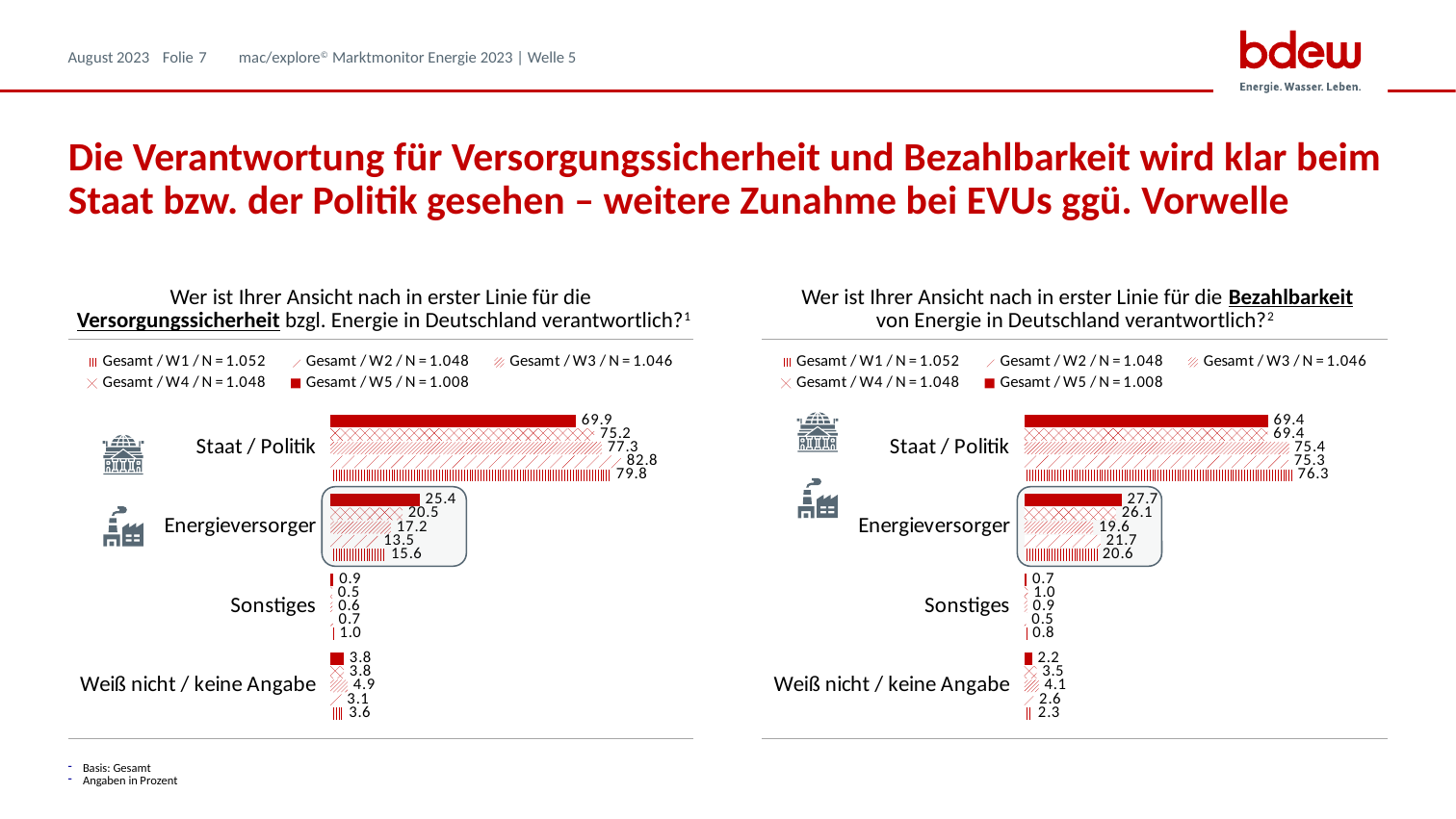
How many categories are shown in the right chart (Bezahlbarkeit)? 4 In the right chart (Bezahlbarkeit), what is the value of the solid red bar (Gesamt / W5) for Energieversorger? 27.7 What sample size (N) is given for Gesamt / W5 in the legend of the right chart (Bezahlbarkeit)? N = 1.008 Comparing the solid red (Gesamt / W5) bars for Energieversorger, which chart shows the larger value: the left (Versorgungssicherheit) or the right (Bezahlbarkeit)? Right (Bezahlbarkeit) In the left chart (Versorgungssicherheit), what is the difference between the Gesamt / W5 value for Staat / Politik (69.9) and for Energieversorger (25.4)? 44.5 What type of chart is used on the left (Versorgungssicherheit)? Bar chart In the left chart (Versorgungssicherheit), what is the value of the solid red bar (Gesamt / W5) for Weiß nicht / keine Angabe? 3.8 How many series does the legend of the left chart (Versorgungssicherheit) list? 5 In the left chart (Versorgungssicherheit), what is the value of the solid red bar (Gesamt / W5) for Staat / Politik? 69.9 In the left chart (Versorgungssicherheit), which category has the highest values? Staat / Politik In the right chart (Bezahlbarkeit), which category has the lowest values? Sonstiges In the right chart (Bezahlbarkeit), what is the difference between the Gesamt / W5 value for Energieversorger (27.7) and the Gesamt / W4 value (26.1)? 1.6